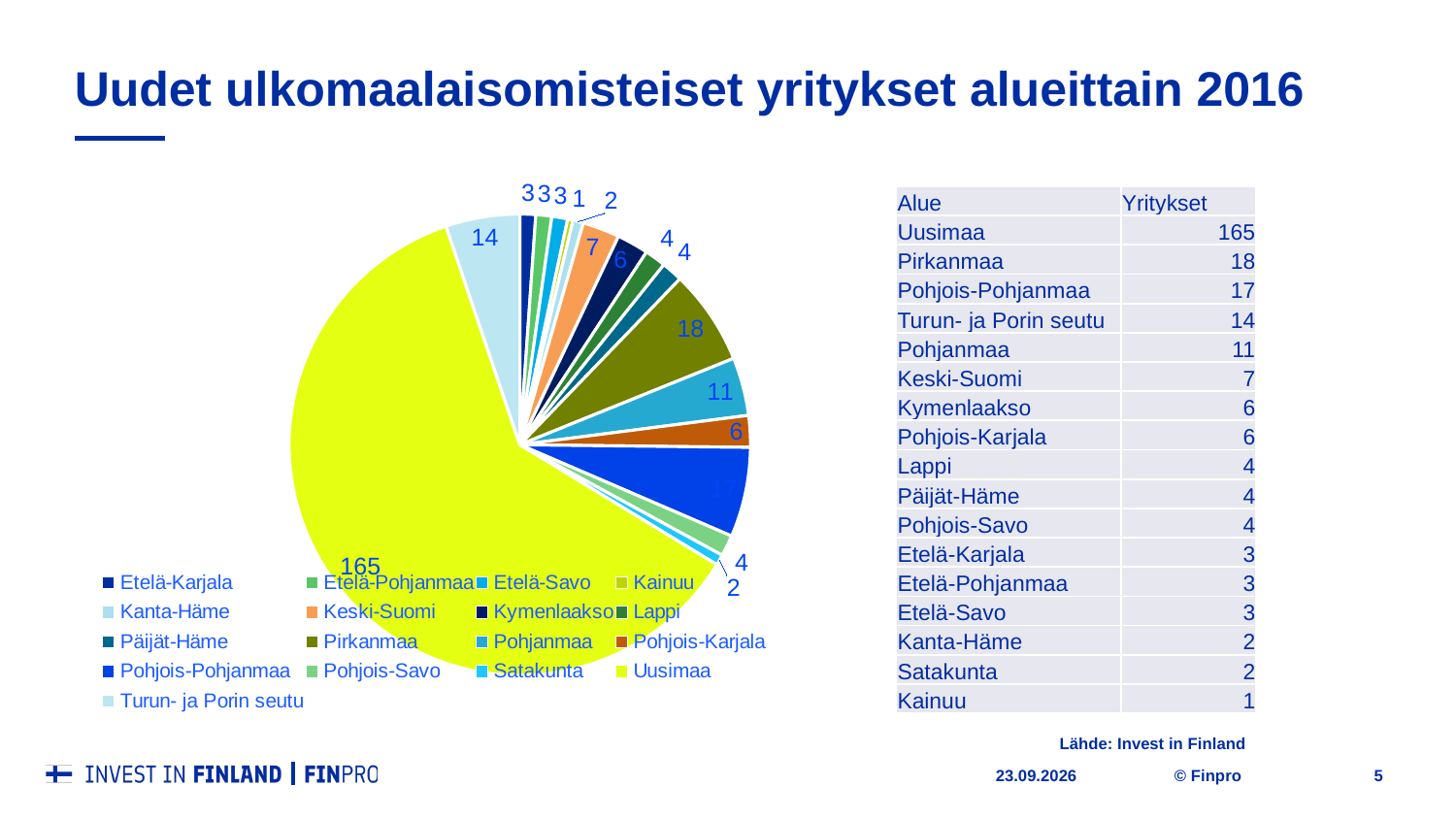
How many regions are listed in the chart legend? 17 Which is larger, the value for Keski-Suomi or the value for Kymenlaakso? Keski-Suomi What is the difference between the values for Pirkanmaa and Pohjois-Pohjanmaa? 1 Which region has the largest slice in the pie chart? Uusimaa What is the value for Pirkanmaa? 18 What is the value for Pohjanmaa? 11 What is the value for Turun- ja Porin seutu? 14 Which region has the smallest value in the chart? Kainuu What is the difference between the values for Uusimaa and Pirkanmaa? 147 What is the value for Uusimaa? 165 What type of chart is shown on the slide? pie chart What is the title of the slide containing the chart? Uudet ulkomaalaisomisteiset yritykset alueittain 2016